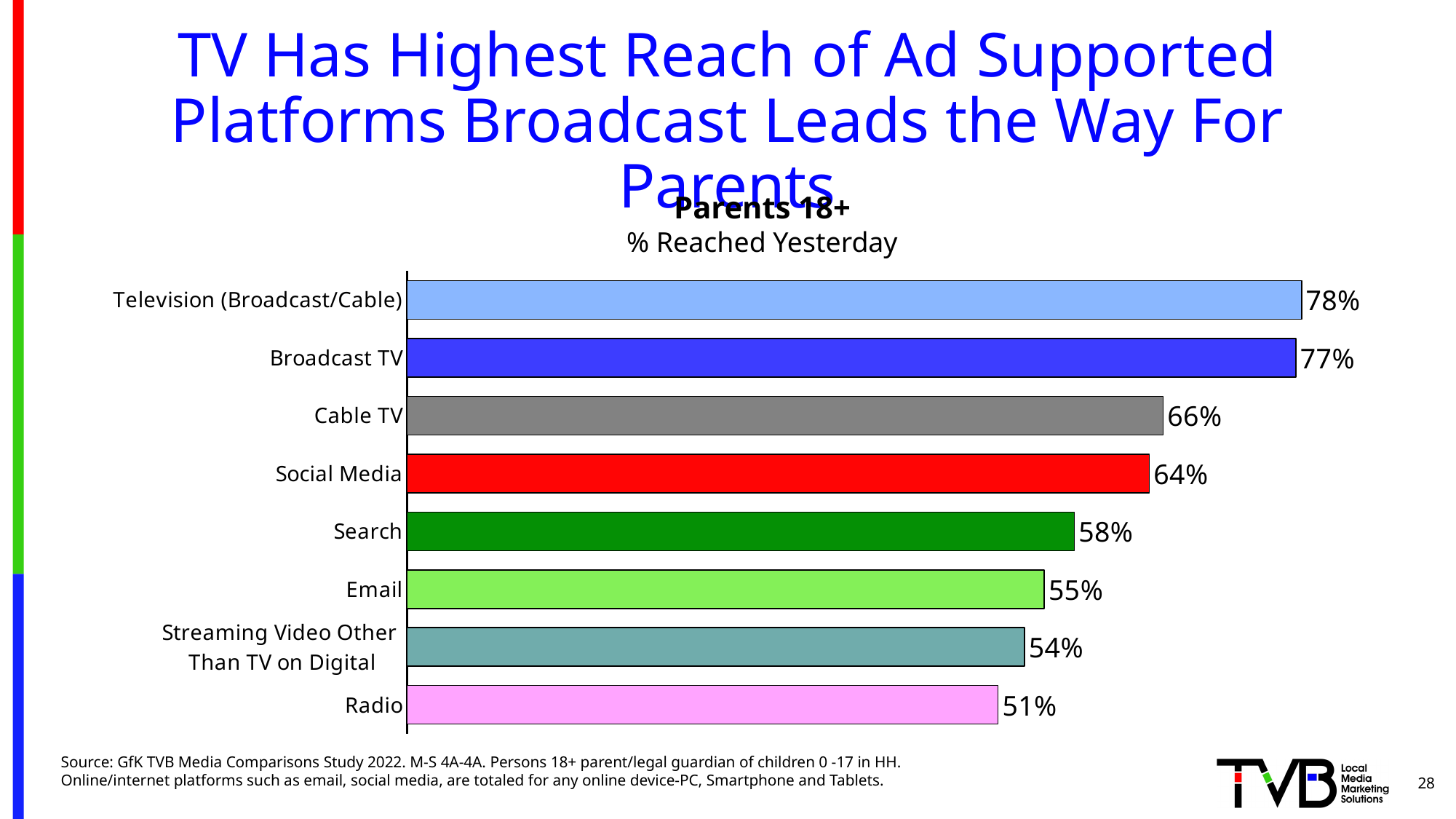
Which is larger, the value for Social Media or the value for Search? Social Media Which is larger, the value for Cable TV or the value for Email? Cable TV What is the value shown for Social Media? 64% Which category has the highest value? Television (Broadcast/Cable) What is the % Reached Yesterday value for Television (Broadcast/Cable)? 78% Which category has the lowest value? Radio What is the subtitle shown below 'Parents 18+' on the chart? % Reached Yesterday What is the difference between the values for Broadcast TV and Cable TV? 11% What kind of chart is shown on the slide? Bar chart What is the difference between the values for Search and Radio? 7% How many categories are shown in the chart? 8 What is the value shown for Streaming Video Other Than TV on Digital? 54%